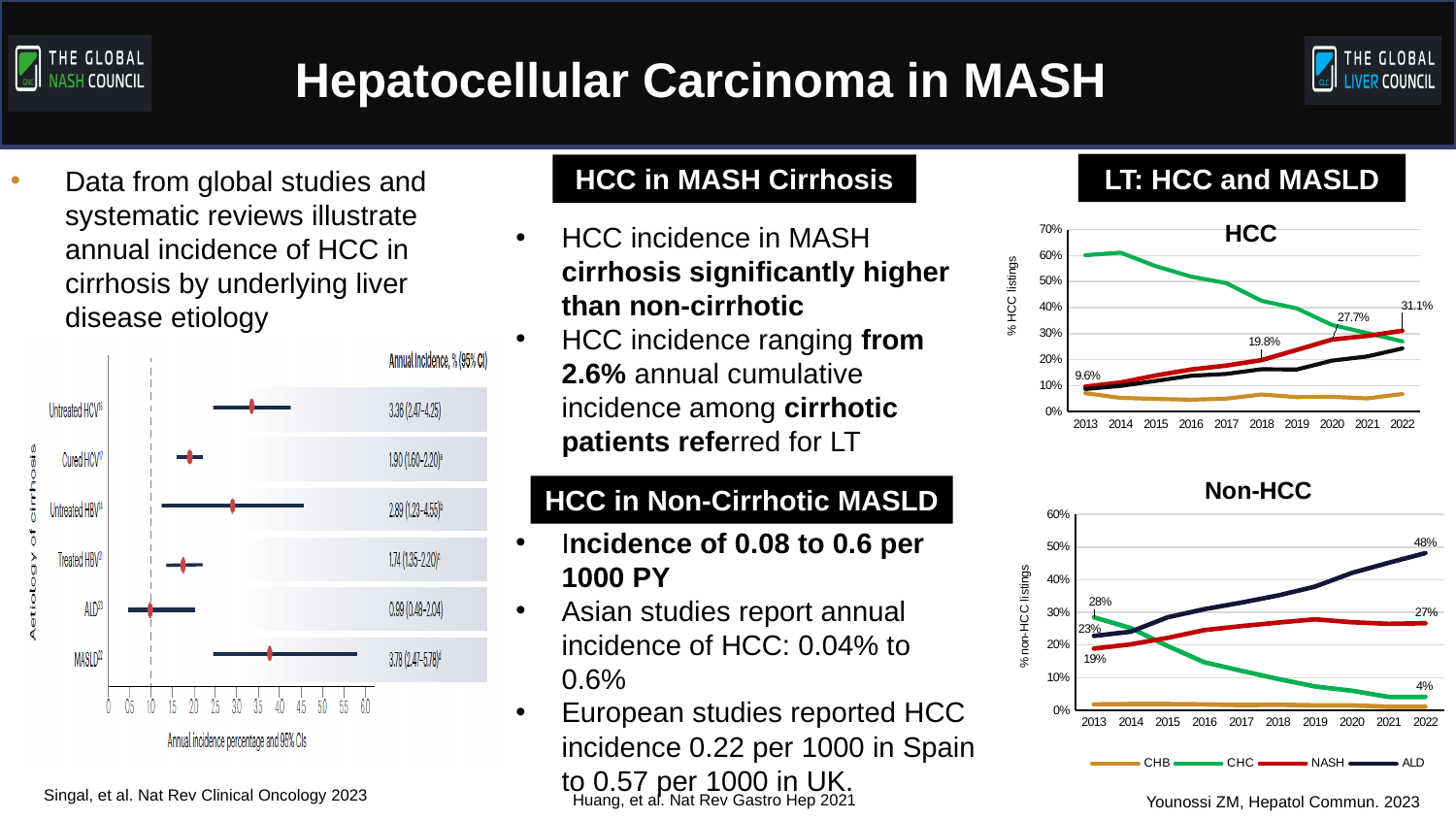
In the Non-HCC chart on the right, what is the difference between the ALD value and the CHC value in 2022? 44% In the forest plot on the left, which aetiology of cirrhosis has the highest annual incidence? MASLD In the forest plot on the left, how many aetiologies of cirrhosis are listed? 6 In the forest plot on the left, which aetiology of cirrhosis has the lowest annual incidence? ALD How many series does the legend below the Non-HCC chart list? 4 In the forest plot on the left, which has a higher annual incidence, Untreated HCV or Cured HCV? Untreated HCV In the HCC chart on the right, does the CHC line rise or fall from 2013 to 2022? fall In the HCC chart on the right, what is the labelled value for the NASH line in 2022? 31.1% In the HCC chart on the right, is the CHC value in 2013 greater or less than 50%? greater In the Non-HCC chart on the right, what is the labelled value for ALD in 2022? 48% In the forest plot on the left, what is the annual incidence for MASLD? 3.78 (2.47-5.78) In the HCC chart on the right, what is the labelled value for the NASH line in 2013? 9.6%